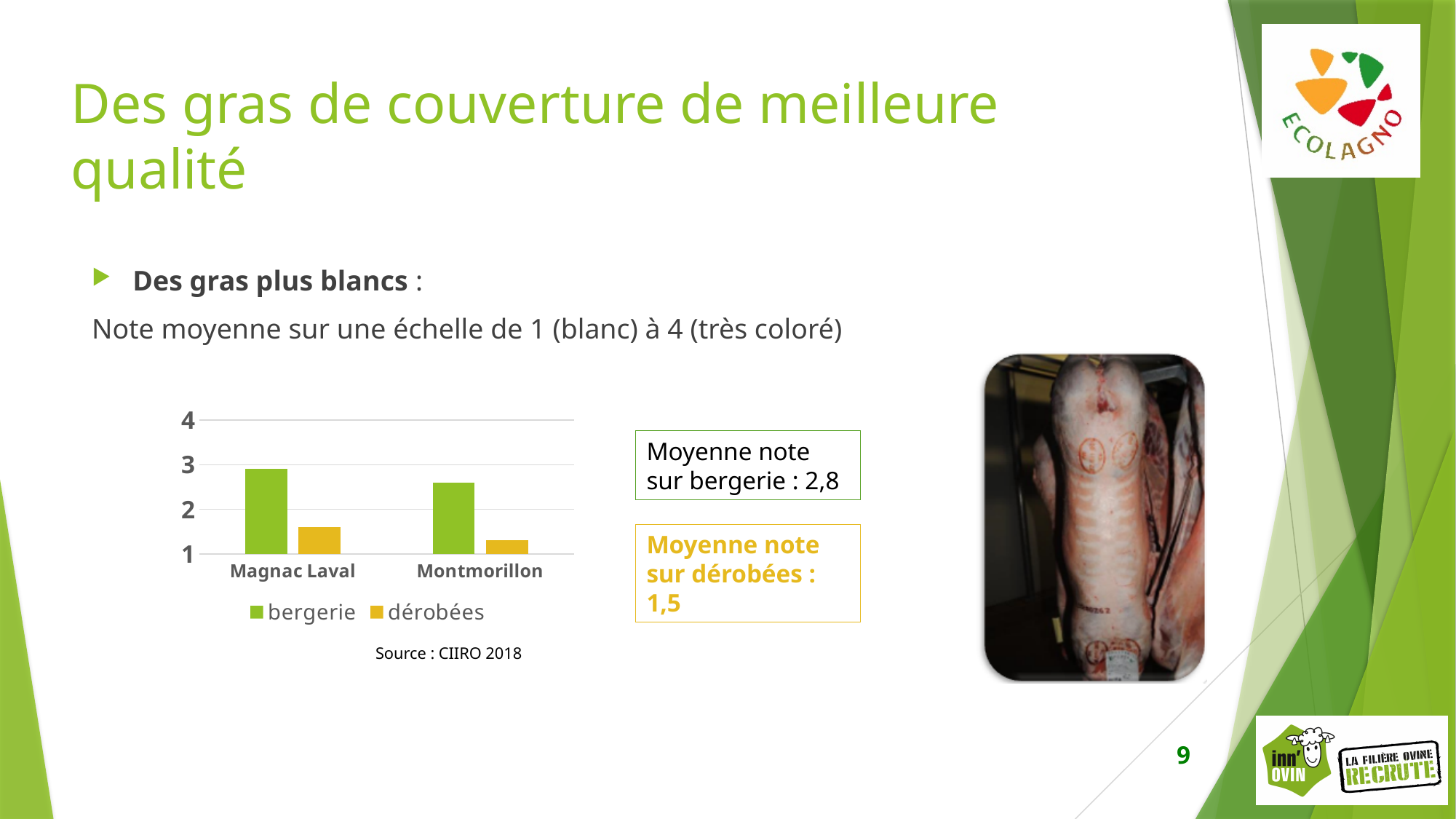
Is the bergerie value for Magnac Laval greater or less than 2? greater Which bar in the chart is the lowest? dérobées for Montmorillon Is the dérobées value for Montmorillon greater or less than 2? less Which category has the higher bergerie value, Magnac Laval or Montmorillon? Magnac Laval What source is cited below the chart? CIIRO 2018 How many series does the chart legend list? 2 How many categories are shown on the x axis of the chart? 2 For Montmorillon, which series has the larger value, bergerie or dérobées? bergerie What kind of chart is shown on the slide? bar chart What are the two series named in the chart legend? bergerie and dérobées Is the dérobées value for Magnac Laval greater or less than 2? less